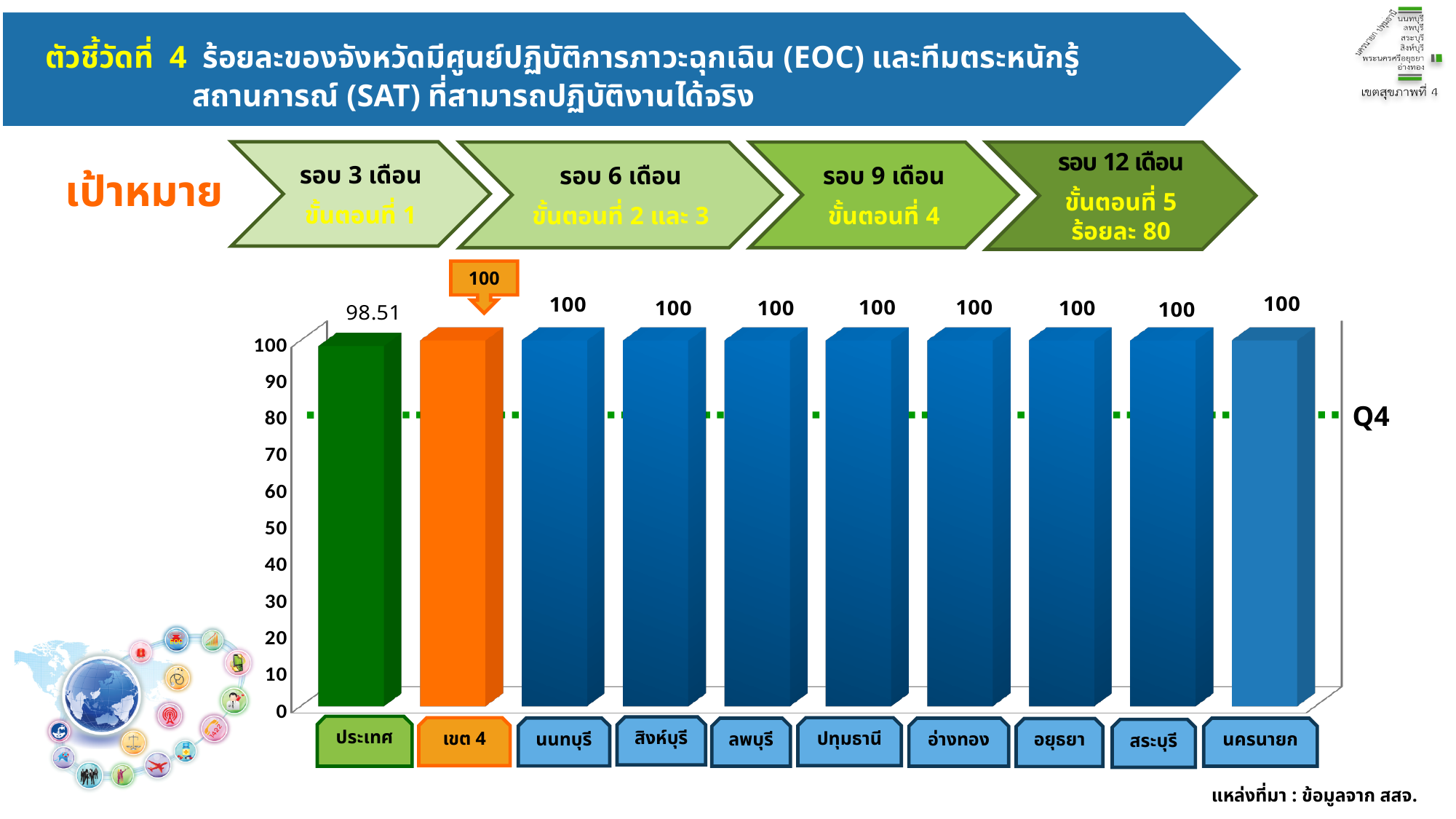
What is the difference between the value for เขต 4 and the value for ประเทศ? 1.49 What is the value for ประเทศ in the bar chart? 98.51 What is the value for นนทบุรี in the bar chart? 100 What is the value for นครนายก in the bar chart? 100 What label is shown next to the dashed horizontal line at 80? Q4 Which is larger, the value for ประเทศ or the value for สระบุรี? สระบุรี What kind of chart is shown on the slide? bar chart Which category has the lowest value in the bar chart? ประเทศ How many categories are shown on the x axis of the bar chart? 10 What colour is the bar for เขต 4? orange What is the value for เขต 4 in the bar chart? 100 Is the value for ปทุมธานี greater or less than 80? greater